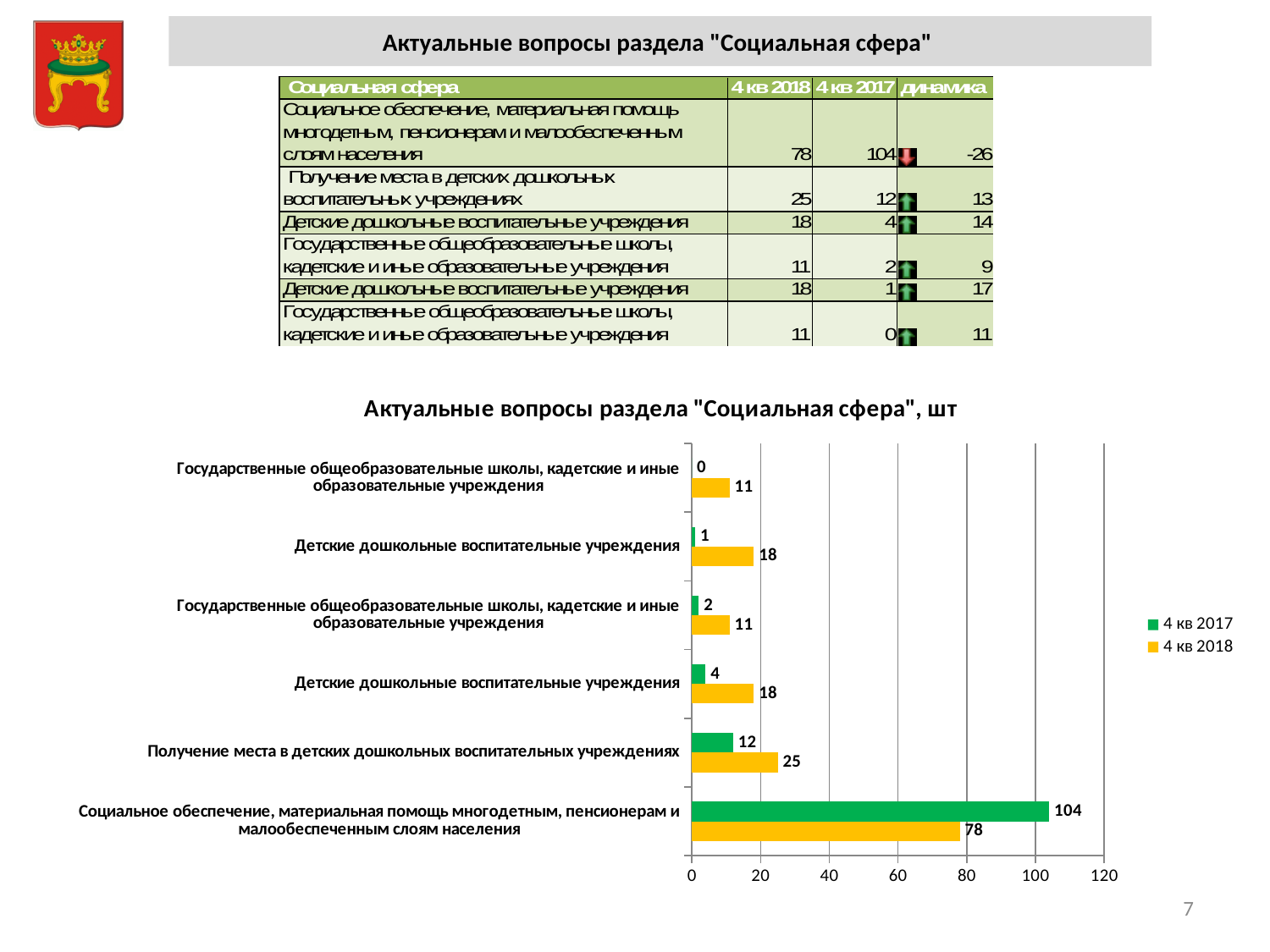
What is the 4 кв 2018 value for "Социальное обеспечение, материальная помощь многодетным, пенсионерам и малообеспеченным слоям населения"? 78 What is the 4 кв 2018 value for "Получение места в детских дошкольных воспитательных учреждениях"? 25 What is the difference between the 4 кв 2018 and 4 кв 2017 values for "Получение места в детских дошкольных воспитательных учреждениях"? 13 Which category has the highest 4 кв 2017 value? Социальное обеспечение, материальная помощь многодетным, пенсионерам и малообеспеченным слоям населения What is the title of the chart? Актуальные вопросы раздела "Социальная сфера", шт What is the difference between the 4 кв 2017 and 4 кв 2018 values for "Социальное обеспечение, материальная помощь многодетным, пенсионерам и малообеспеченным слоям населения"? 26 How many categories are plotted on the chart? 6 What type of chart is shown on the slide? bar chart How many series does the chart legend list? 2 What is the 4 кв 2017 value for "Социальное обеспечение, материальная помощь многодетным, пенсионерам и малообеспеченным слоям населения"? 104 For "Получение места в детских дошкольных воспитательных учреждениях", which series has the larger value, 4 кв 2017 or 4 кв 2018? 4 кв 2018 What is the 4 кв 2017 value for "Получение места в детских дошкольных воспитательных учреждениях"? 12